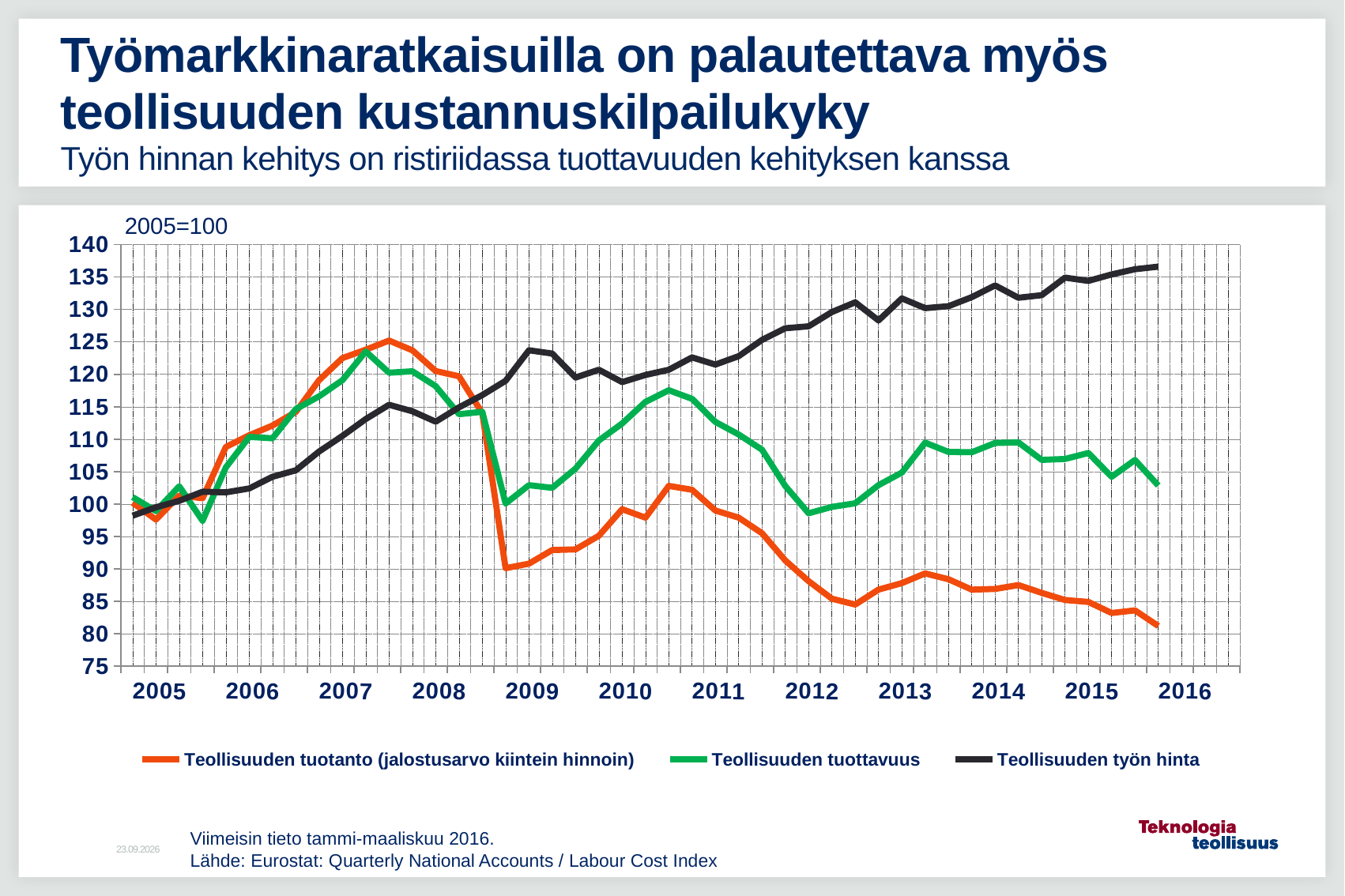
Is the value for Teollisuuden työn hinta at the end of the series in 2016 greater or less than 130? greater Does Teollisuuden työn hinta generally rise or fall from 2005 to 2016? rise Is the value for Teollisuuden tuotanto at the end of the series in 2016 greater or less than 85? less Is the value for Teollisuuden tuottavuus at the end of the series in 2016 greater or less than 100? greater What kind of chart is shown on the slide? line chart Does Teollisuuden tuotanto generally rise or fall from 2011 to 2016? fall Which series are listed in the legend? Teollisuuden tuotanto (jalostusarvo kiintein hinnoin), Teollisuuden tuottavuus, Teollisuuden työn hinta How many series does the legend list? 3 Which series has the lowest value at the end of the series in 2016? Teollisuuden tuotanto (jalostusarvo kiintein hinnoin) Which series has the highest value at the end of the series in 2016? Teollisuuden työn hinta What base year and index value is stated above the chart? 2005=100